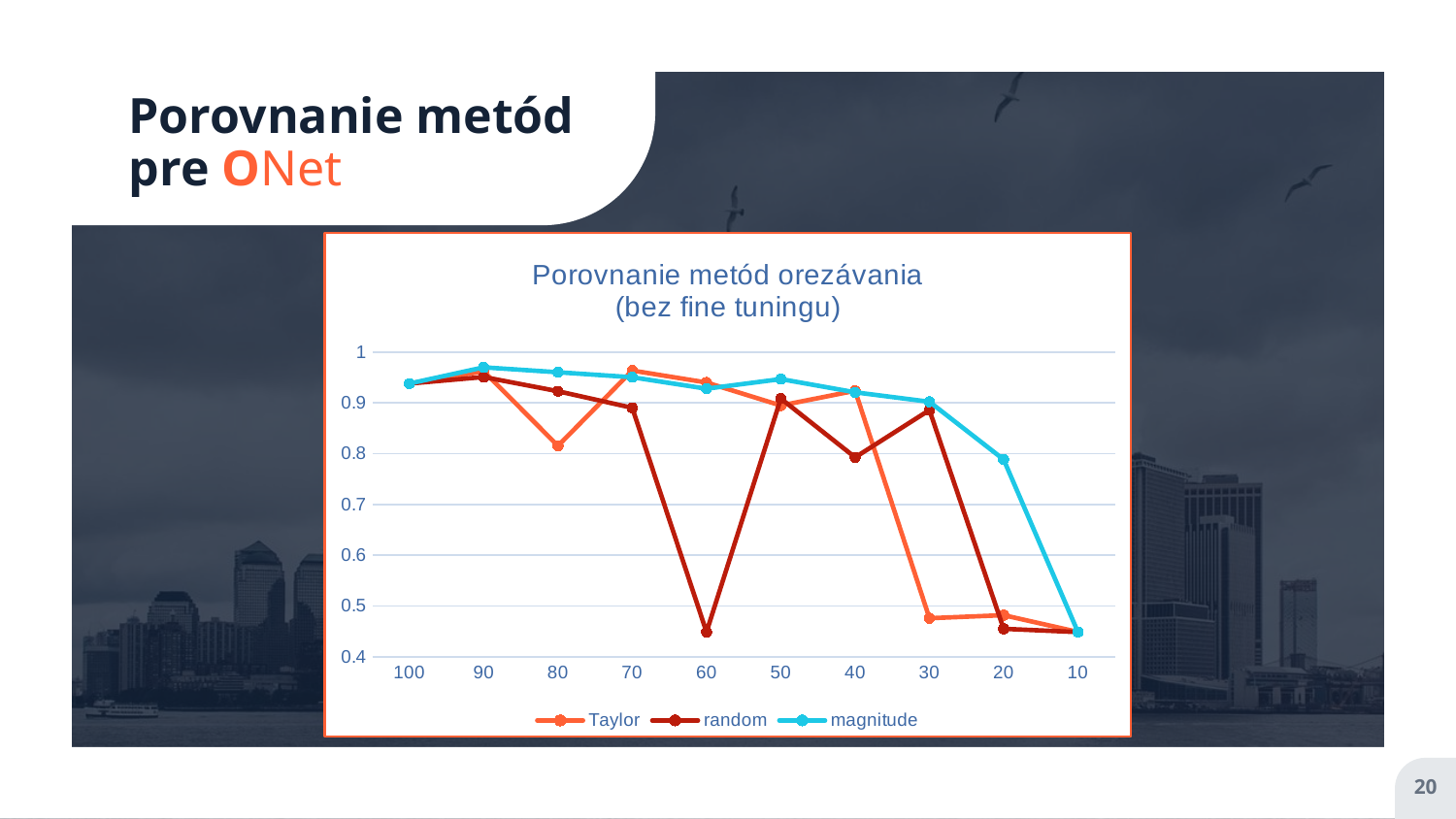
Is the value of the random series at x = 60 greater or less than 0.5? less How many points are marked along the x axis of the chart? 10 How many series does the legend of the chart list? 3 At x = 30, which series has the larger value, Taylor or magnitude? magnitude What kind of chart is shown on the slide? line chart At x = 60, which series has the larger value, random or magnitude? magnitude At x = 40, which series has the lowest value? random Is the value of the magnitude series at x = 20 greater or less than 0.7? greater Does the magnitude series rise or fall overall from x = 100 to x = 10? fall Is the value of the Taylor series at x = 30 greater or less than 0.5? less What is the title of the chart? Porovnanie metód orezávania (bez fine tuningu)